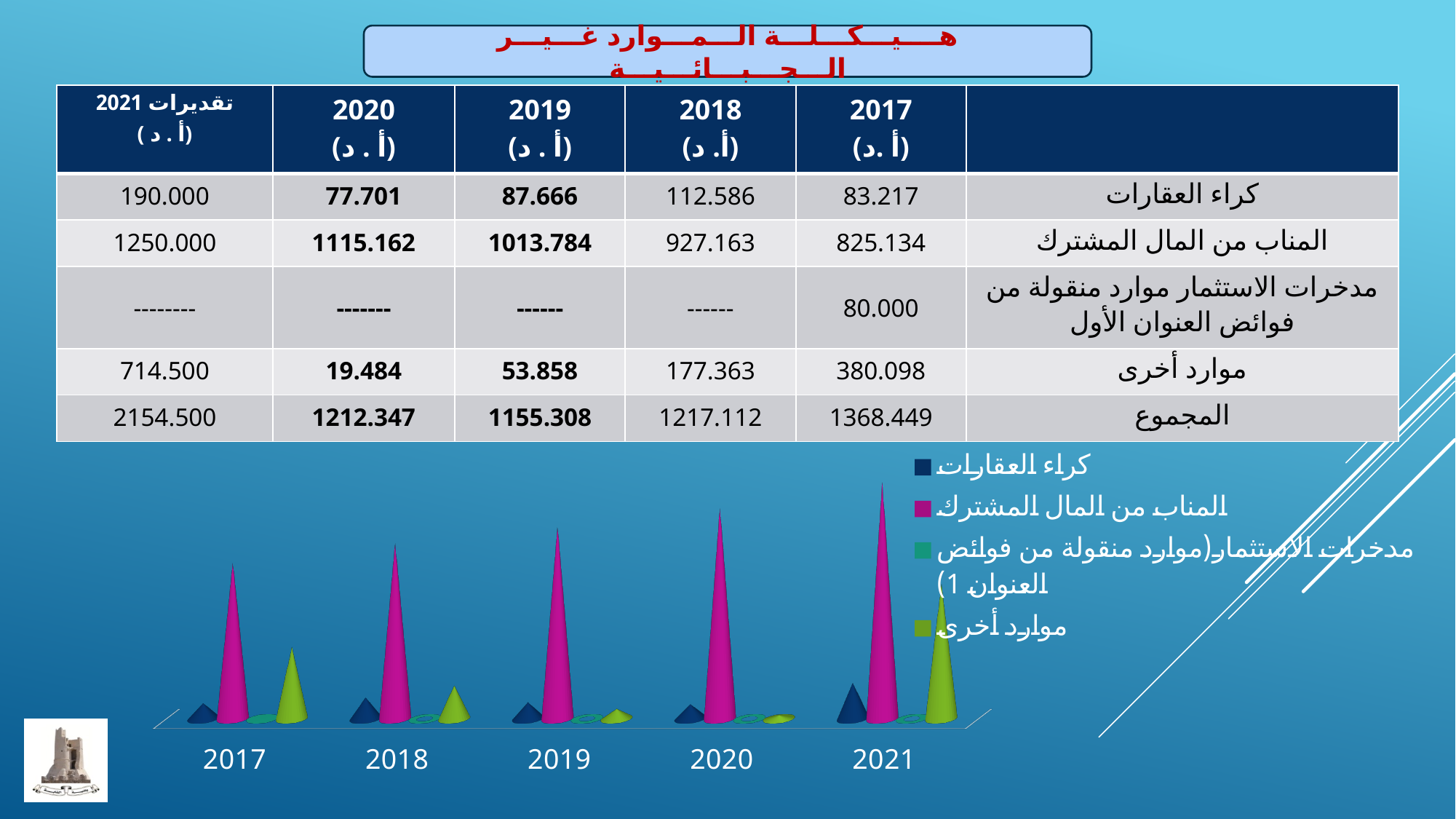
What is the value plotted for المناب من المال المشترك in 2021, as given in the table on the slide? 1250.000 What kind of chart is shown at the bottom of the slide? bar chart How many years are shown along the x axis of the chart? 5 What is the value plotted for موارد أخرى in 2020, as given in the table on the slide? 19.484 In 2021, which is larger in the chart: موارد أخرى or كراء العقارات? موارد أخرى Which series is shown in green in the chart? موارد أخرى How many series does the chart legend list? 4 In which year is the value for موارد أخرى lowest in the chart? 2020 In 2017, which is larger in the chart: المناب من المال المشترك or كراء العقارات? المناب من المال المشترك In which year is the value for المناب من المال المشترك highest in the chart? 2021 Which series is shown in pink/magenta in the chart? المناب من المال المشترك Does the value for المناب من المال المشترك rise or fall from 2017 to 2021 in the chart? rise